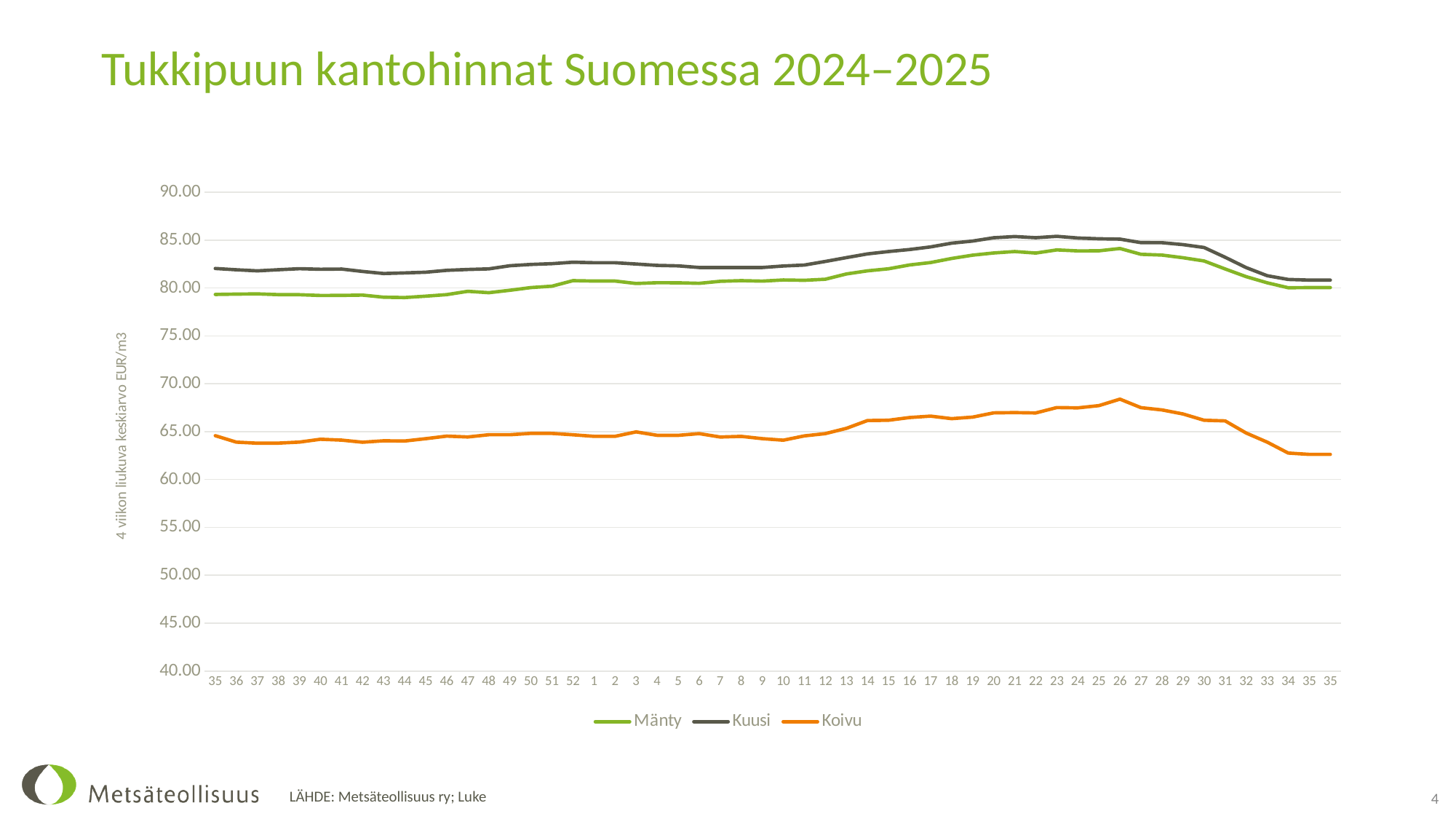
Which series has the lowest values throughout the chart? Koivu Is the value for Mänty at week 44 greater or less than 80? less What is the title of the chart? Tukkipuun kantohinnat Suomessa 2024–2025 Does the Koivu line rise or fall between week 26 and week 34? fall Is the value for Koivu at week 34 greater or less than 65? less Is the value for Koivu at week 26 greater or less than 65? greater What kind of chart is shown on the slide? line chart Which series has the highest values throughout the chart? Kuusi At week 20, which is larger, the value for Mänty or the value for Kuusi? Kuusi Does the Kuusi line rise or fall between week 10 and week 21? rise How many series does the legend list? 3